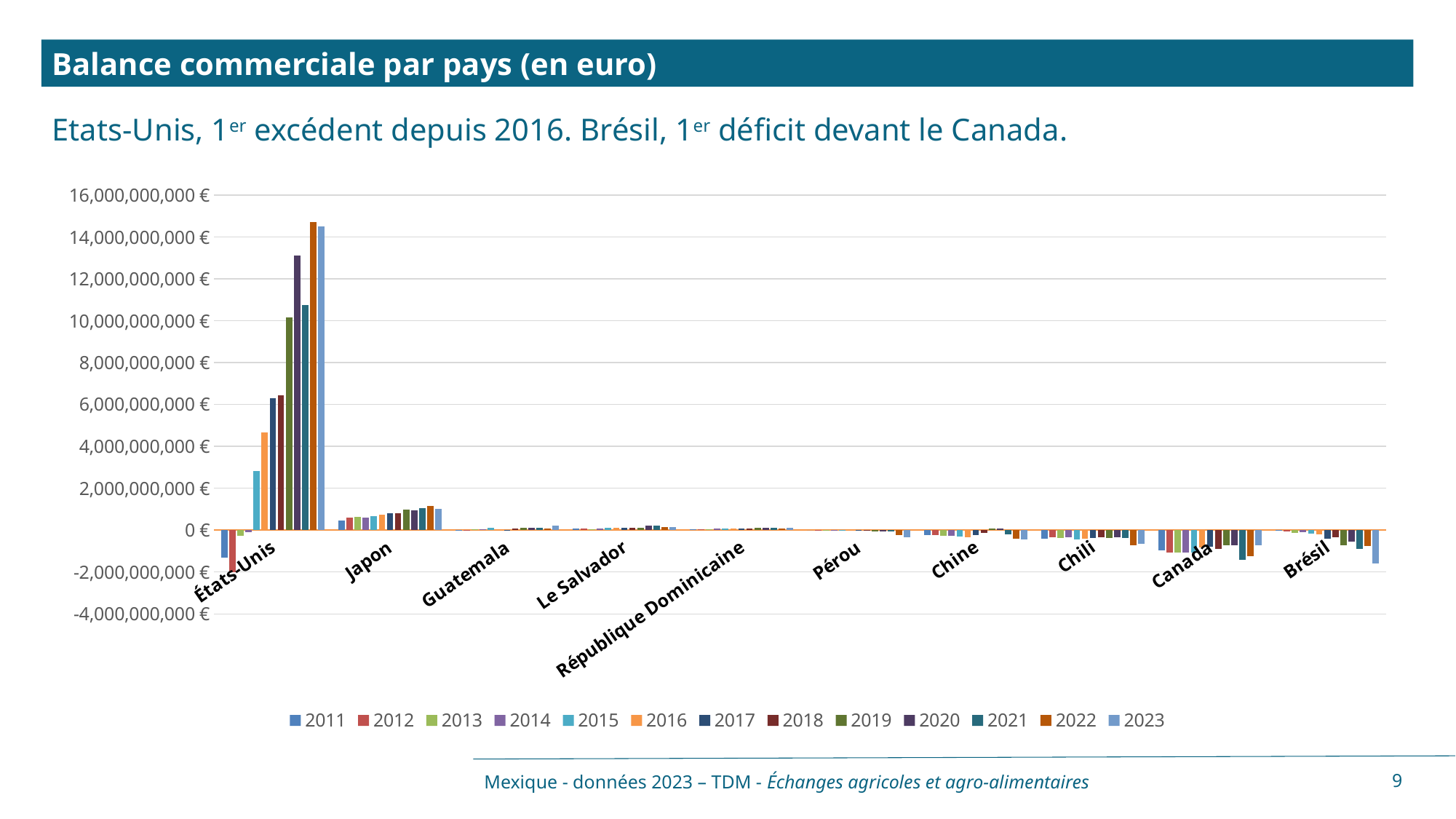
Is the value for États-Unis in 2016 greater or less than 4,000,000,000 €? greater For États-Unis, do the values generally rise or fall from 2015 to 2022? rise Is the value for États-Unis in 2020 greater or less than 12,000,000,000 €? greater Which country has the highest bar on the chart? États-Unis What kind of chart is shown on the slide? bar chart How many series does the legend list? 13 What is the title of the chart on the slide? Balance commerciale par pays (en euro) Is the value for États-Unis in 2022 greater or less than 14,000,000,000 €? greater How many countries are labelled on the x axis? 10 Which is larger, the 2023 value for États-Unis or the 2023 value for Japon? États-Unis